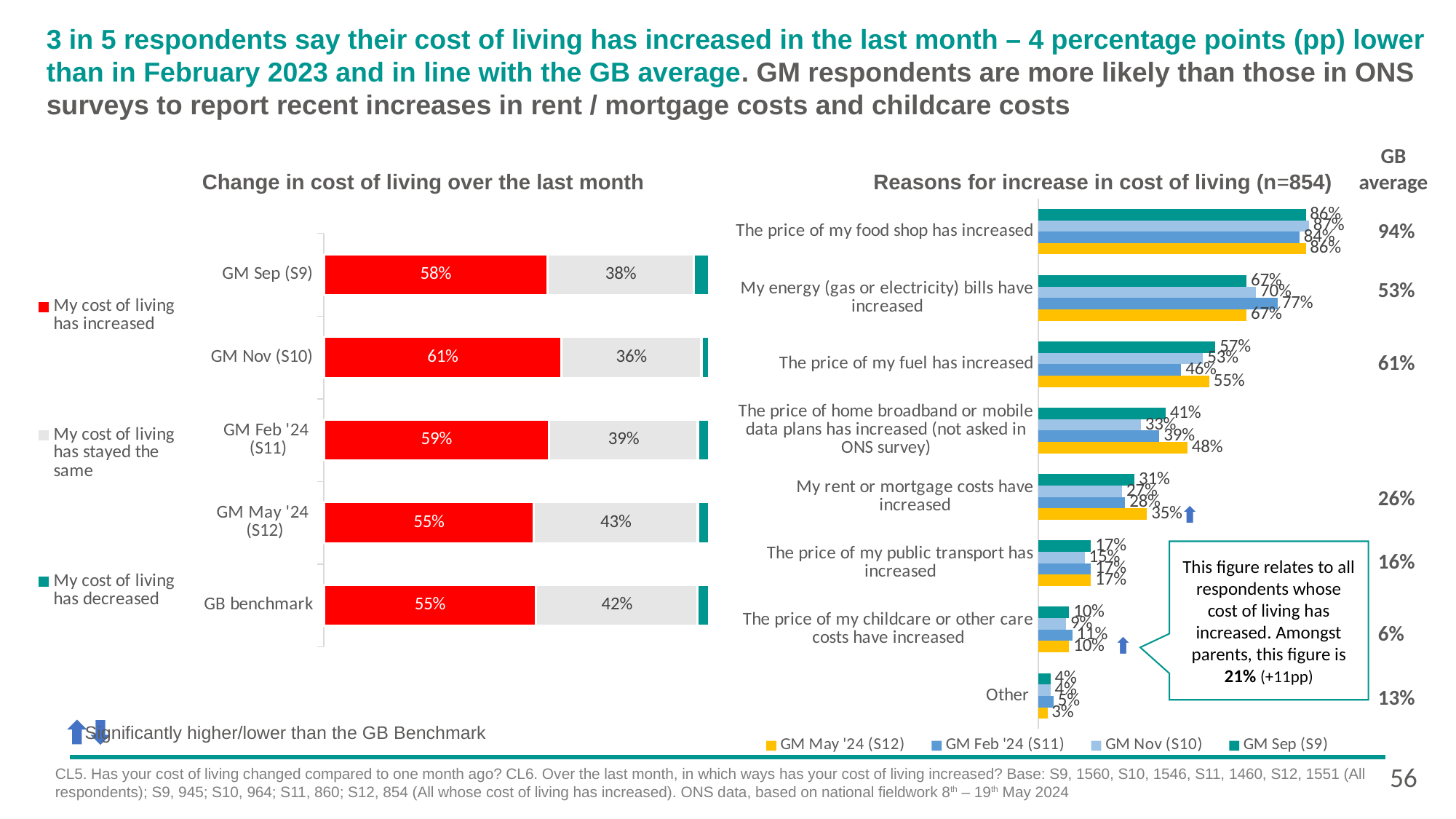
In the chart 'Reasons for increase in cost of living (n=854)', what is the GM May '24 (S12) value for 'The price of my fuel has increased'? 55% In the chart 'Change in cost of living over the last month', what percentage of GM Nov (S10) respondents said their cost of living has increased? 61% In the chart 'Change in cost of living over the last month', what percentage of GM May '24 (S12) respondents said their cost of living has stayed the same? 43% In the chart 'Reasons for increase in cost of living (n=854)', for 'The price of home broadband or mobile data plans has increased', which is larger: the GM May '24 (S12) value or the GM Sep (S9) value? GM May '24 (S12) How many series does the legend list for the chart 'Change in cost of living over the last month'? 3 In the chart 'Reasons for increase in cost of living (n=854)', what is the GM May '24 (S12) value for 'My rent or mortgage costs have increased'? 35% How many categories (bars) are shown in the chart 'Change in cost of living over the last month'? 5 What type of chart is 'Change in cost of living over the last month'? Stacked bar chart How many series does the legend list for the chart 'Reasons for increase in cost of living (n=854)'? 4 In the chart 'Change in cost of living over the last month', which category has the highest share saying their cost of living has increased? GM Nov (S10) In the chart 'Reasons for increase in cost of living (n=854)', which reason has the highest GM May '24 (S12) value? The price of my food shop has increased In the chart 'Change in cost of living over the last month', how many percentage points higher is the 'increased' share for GM Sep (S9) than for the GB benchmark? 3 percentage points